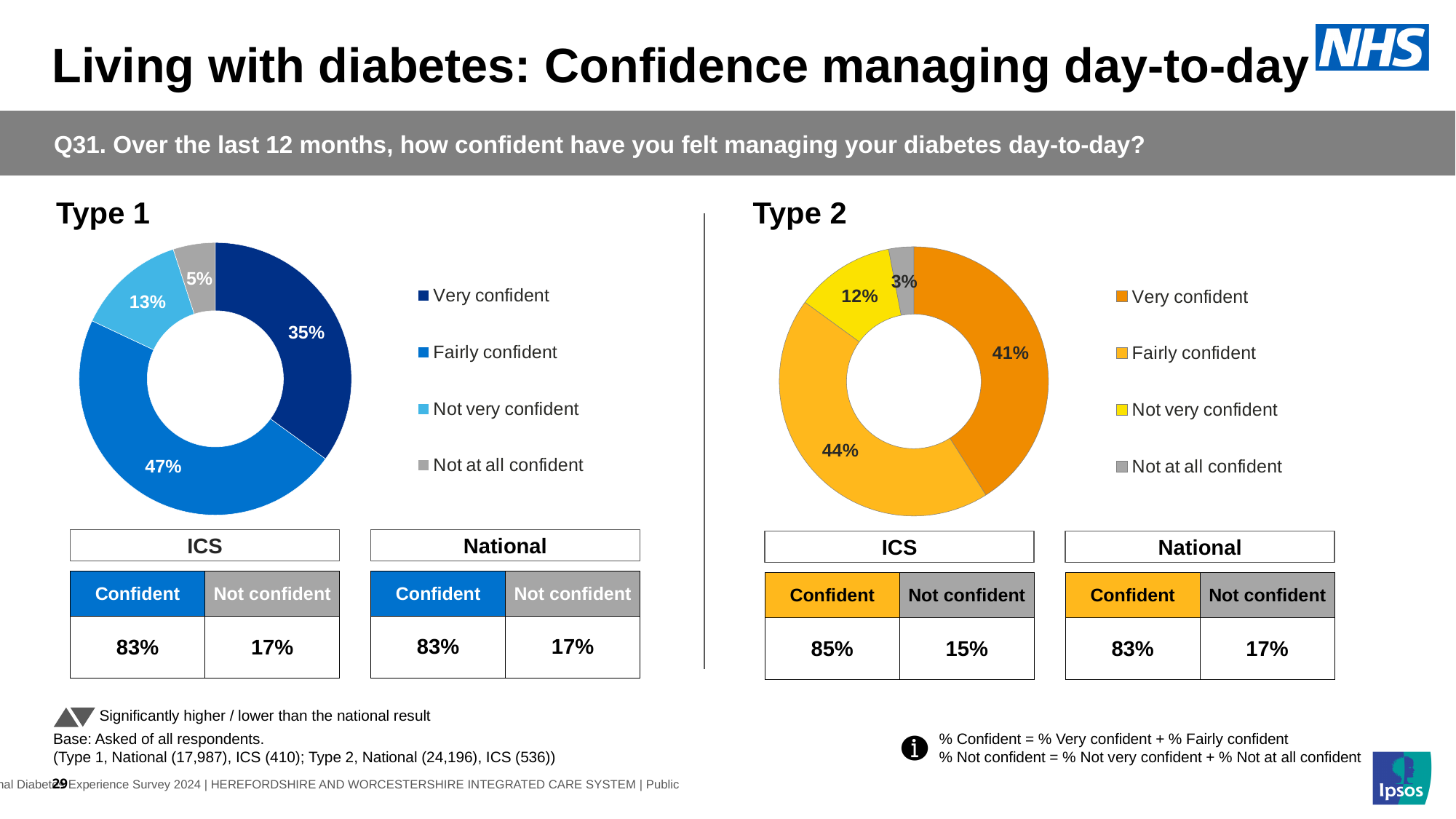
In the Type 1 chart, what is the difference between the Fairly confident and Very confident shares? 12% In the Type 2 chart, what is the combined share of Very confident and Fairly confident? 85% In the Type 1 chart, what percentage of respondents were Not at all confident? 5% How many categories does the Type 1 chart show? 4 In the Type 2 chart, which is larger: Very confident or Not very confident? Very confident In the Type 1 chart, what percentage of respondents were Fairly confident? 47% In the Type 1 chart, what colour represents Not at all confident? Grey In the Type 2 chart, what percentage of respondents were Not very confident? 12% What kind of chart is the Type 2 chart? Donut chart In the Type 2 chart, which category has the smallest share? Not at all confident In the Type 2 chart, what percentage of respondents were Very confident? 41% In the Type 1 chart, which category has the largest share? Fairly confident